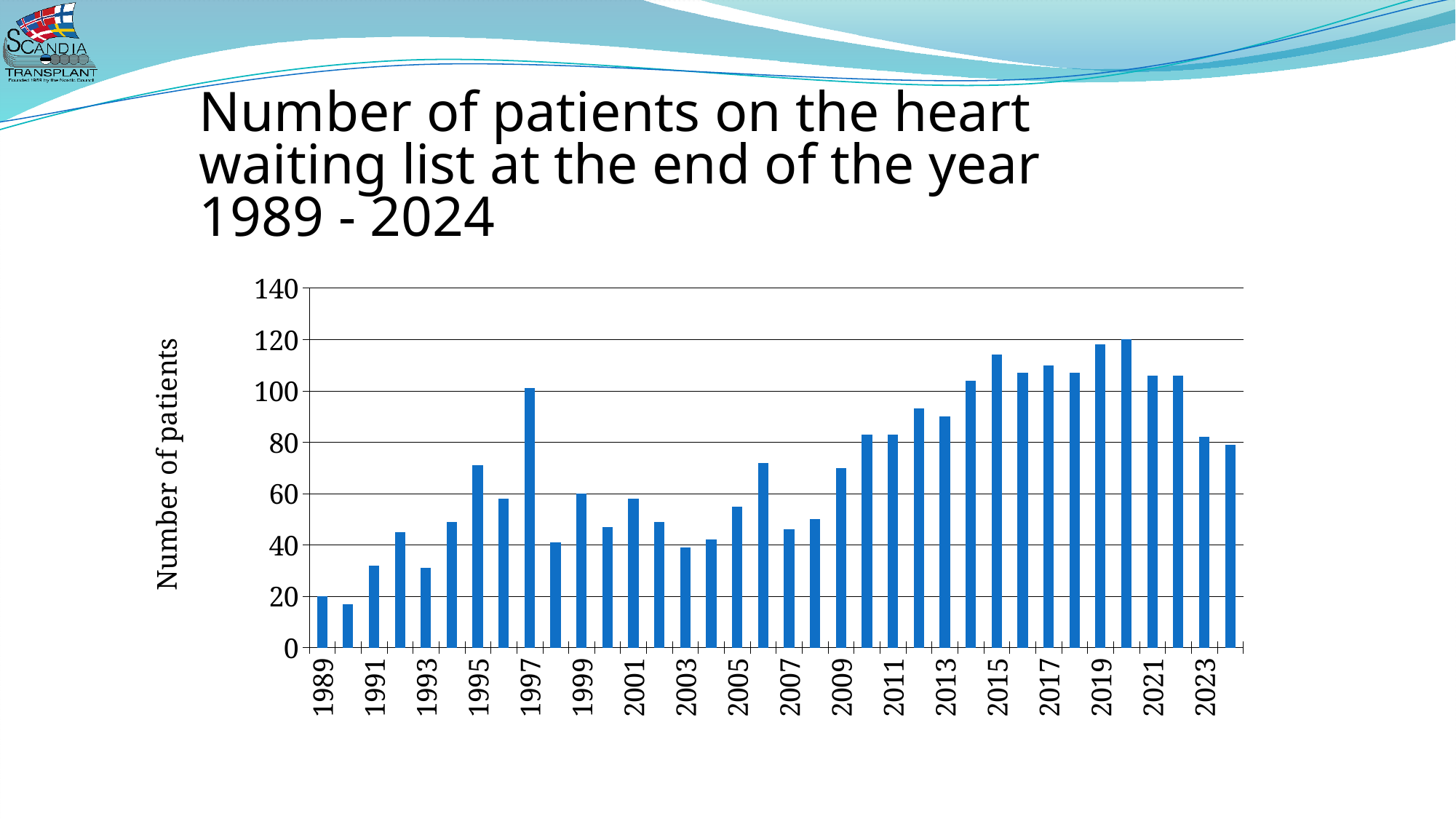
Which year has the lowest number of patients on the heart waiting list? 1990 What kind of chart is shown on the slide? bar chart What is the number of patients on the heart waiting list at the end of 2020? 120 Is the value for 1997 greater or less than 80? greater Which year has more patients on the waiting list, 1995 or 1997? 1997 What is the number of patients on the heart waiting list at the end of 1989? 20 Is the value for 2003 greater or less than 60? less Which year has the highest number of patients on the heart waiting list? 2020 Is the value for 2024 greater or less than 100? less What is the label on the vertical axis of the chart? Number of patients Do the values rise or fall from 2020 to 2024? fall